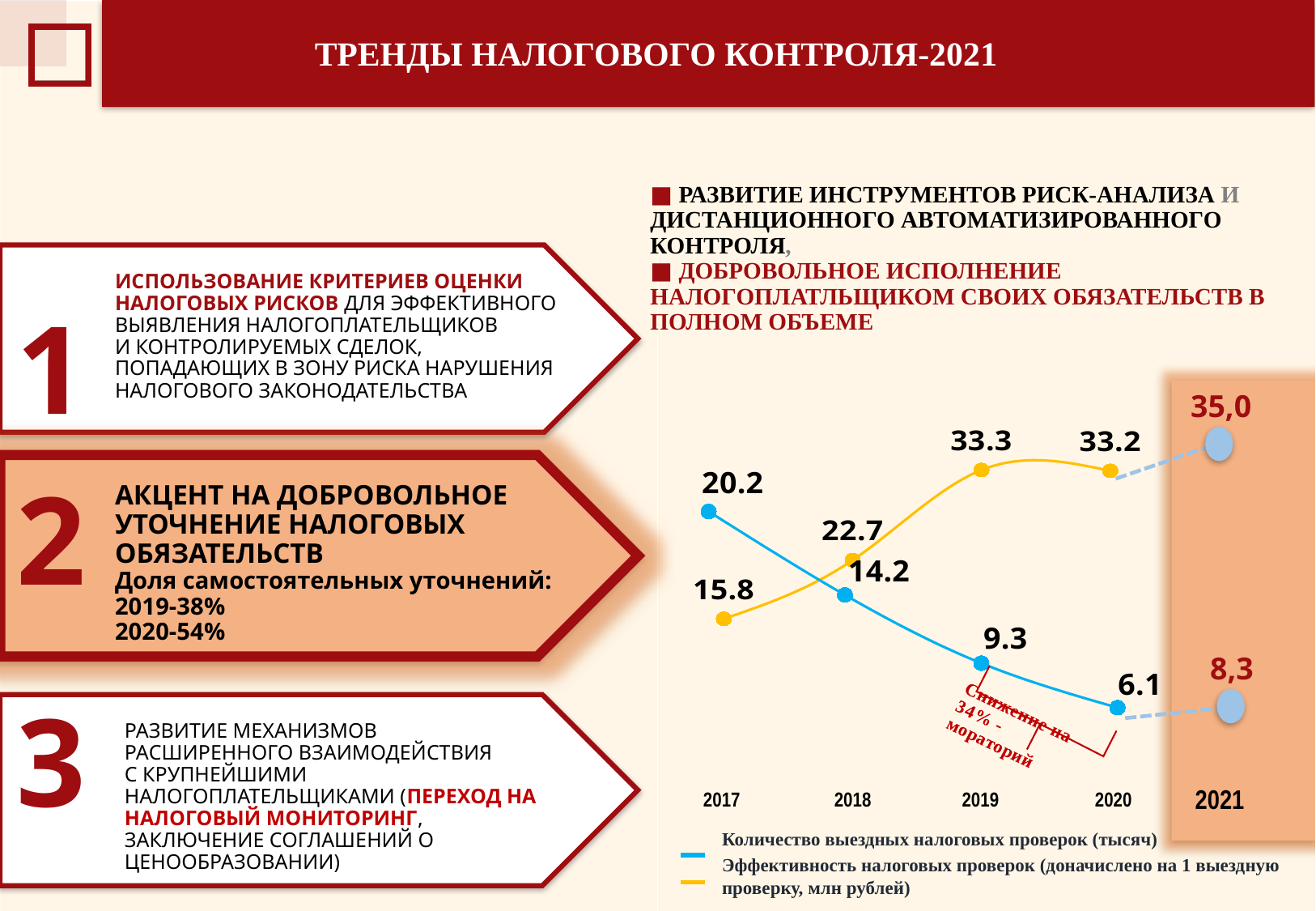
What is the value of the blue line (Количество выездных налоговых проверок) for 2020? 6.1 What kind of chart is shown on the slide? line chart How many years are shown on the x axis of the chart? 5 How many series does the chart legend list? 2 What is the value shown for 2021 on the yellow line (Эффективность налоговых проверок)? 35,0 Which is larger in 2018: the blue line value or the yellow line value? the yellow line (22.7) Does the blue line (Количество выездных налоговых проверок) rise or fall from 2017 to 2020? fall In which year is the blue line (Количество выездных налоговых проверок) at its lowest? 2020 What is the value of the blue line (Количество выездных налоговых проверок) for 2017? 20.2 What is the value of the yellow line (Эффективность налоговых проверок) for 2019? 33.3 What is the difference between the blue line values for 2017 and 2018? 6.0 In which year is the yellow line (Эффективность налоговых проверок) at its highest? 2021